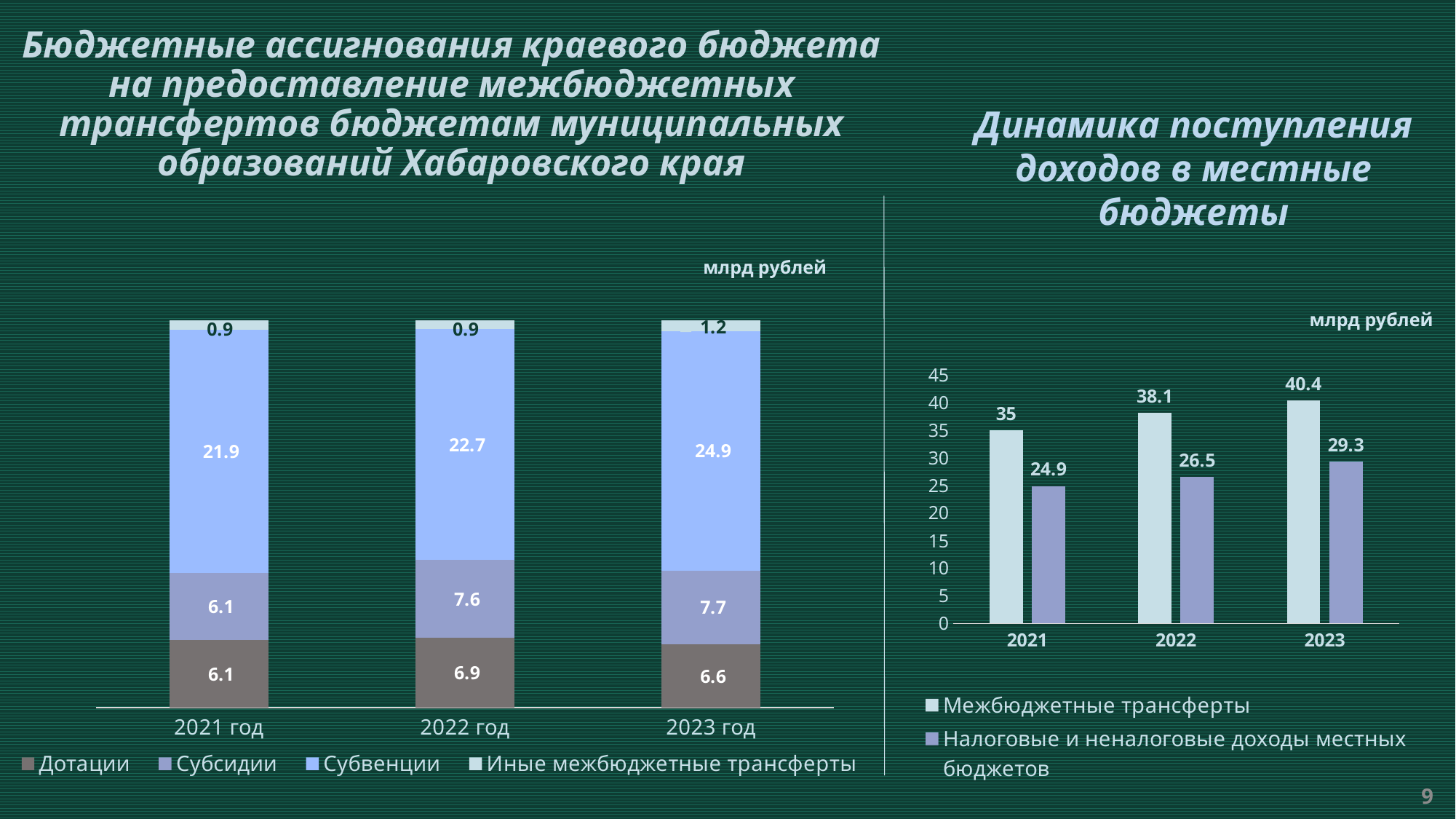
On the left chart (Бюджетные ассигнования краевого бюджета), what is the total of the stacked bar for 2021 год? 35.0 On the left chart (Бюджетные ассигнования краевого бюджета), what kind of chart is it? Stacked bar chart On the right chart (Динамика поступления доходов в местные бюджеты), what is the value of Налоговые и неналоговые доходы местных бюджетов for 2023? 29.3 On the left chart (Бюджетные ассигнования краевого бюджета), in which year is Субвенции highest? 2023 год On the right chart (Динамика поступления доходов в местные бюджеты), what is the value of Межбюджетные трансферты for 2022? 38.1 On the right chart (Динамика поступления доходов в местные бюджеты), what is the difference between Межбюджетные трансферты and Налоговые и неналоговые доходы местных бюджетов in 2021? 10.1 On the left chart (Бюджетные ассигнования краевого бюджета), what is the value of Субвенции for 2022 год? 22.7 On the left chart (Бюджетные ассигнования краевого бюджета), how many series does the legend list? 4 On the left chart (Бюджетные ассигнования краевого бюджета), what is the difference between Субсидии in 2023 год and 2021 год? 1.6 On the left chart (Бюджетные ассигнования краевого бюджета), what is the value of Дотации for 2023 год? 6.6 On the right chart (Динамика поступления доходов в местные бюджеты), do the values of Межбюджетные трансферты rise or fall from 2021 to 2023? Rise On the right chart (Динамика поступления доходов в местные бюджеты), how many years are shown on the x axis? 3